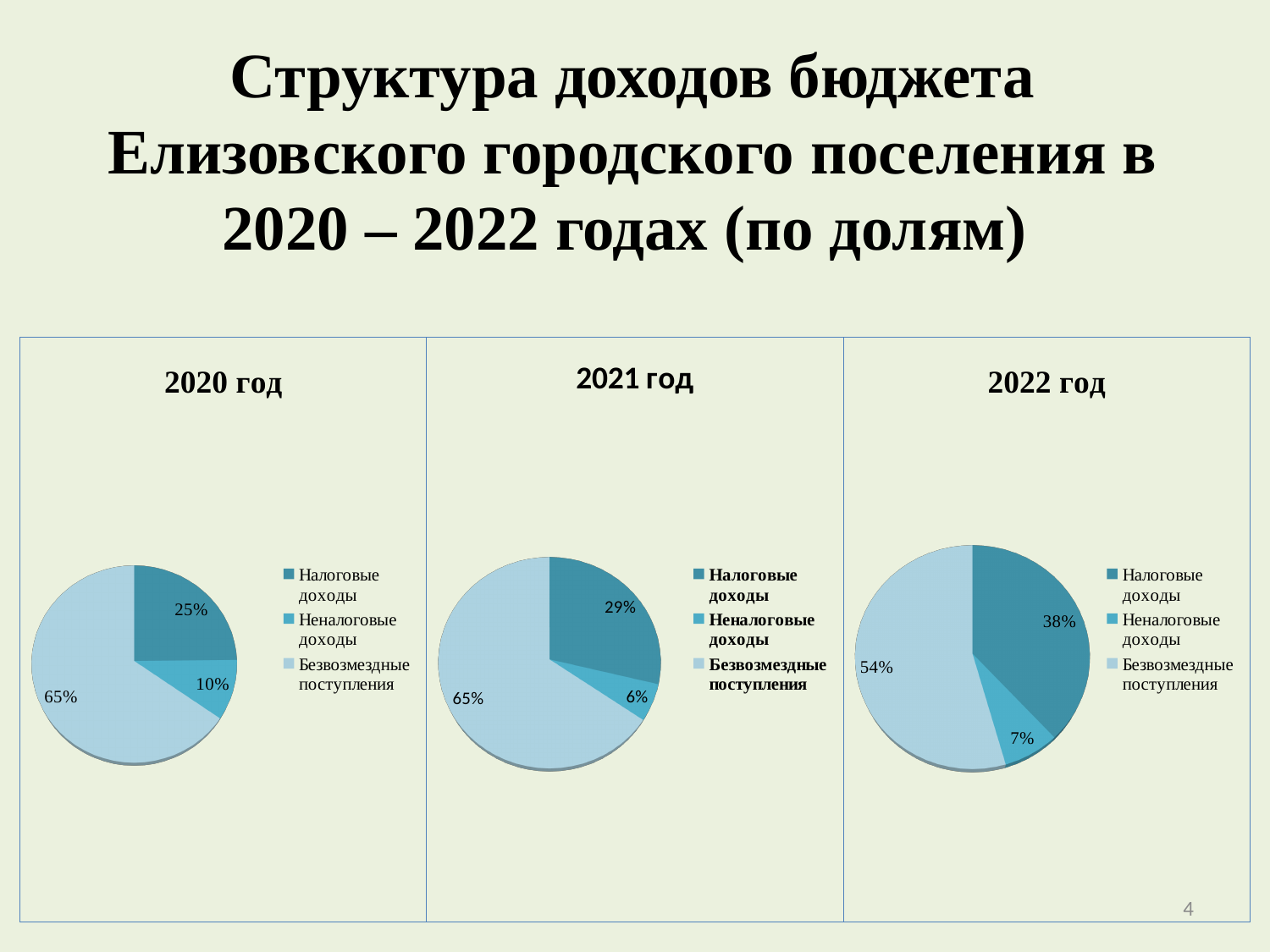
In the 2022 год chart, which category has the smallest share? Неналоговые доходы In the 2020 год chart, which category has the largest share? Безвозмездные поступления In the 2022 год chart, what share is Налоговые доходы? 38% In the 2021 год chart, what share is Безвозмездные поступления? 65% In the 2020 год chart, what share is Неналоговые доходы? 10% In the 2020 год chart, what share is Налоговые доходы? 25% Which is larger: Налоговые доходы in the 2022 год chart or Налоговые доходы in the 2020 год chart? 2022 год How many categories does the legend of the 2022 год chart list? 3 In the 2022 год chart, what share is Безвозмездные поступления? 54% In the 2021 год chart, what is the difference between the shares of Налоговые доходы and Неналоговые доходы? 23% In the 2021 год chart, what share is Неналоговые доходы? 6% What kind of chart is used in the 2021 год panel? pie chart